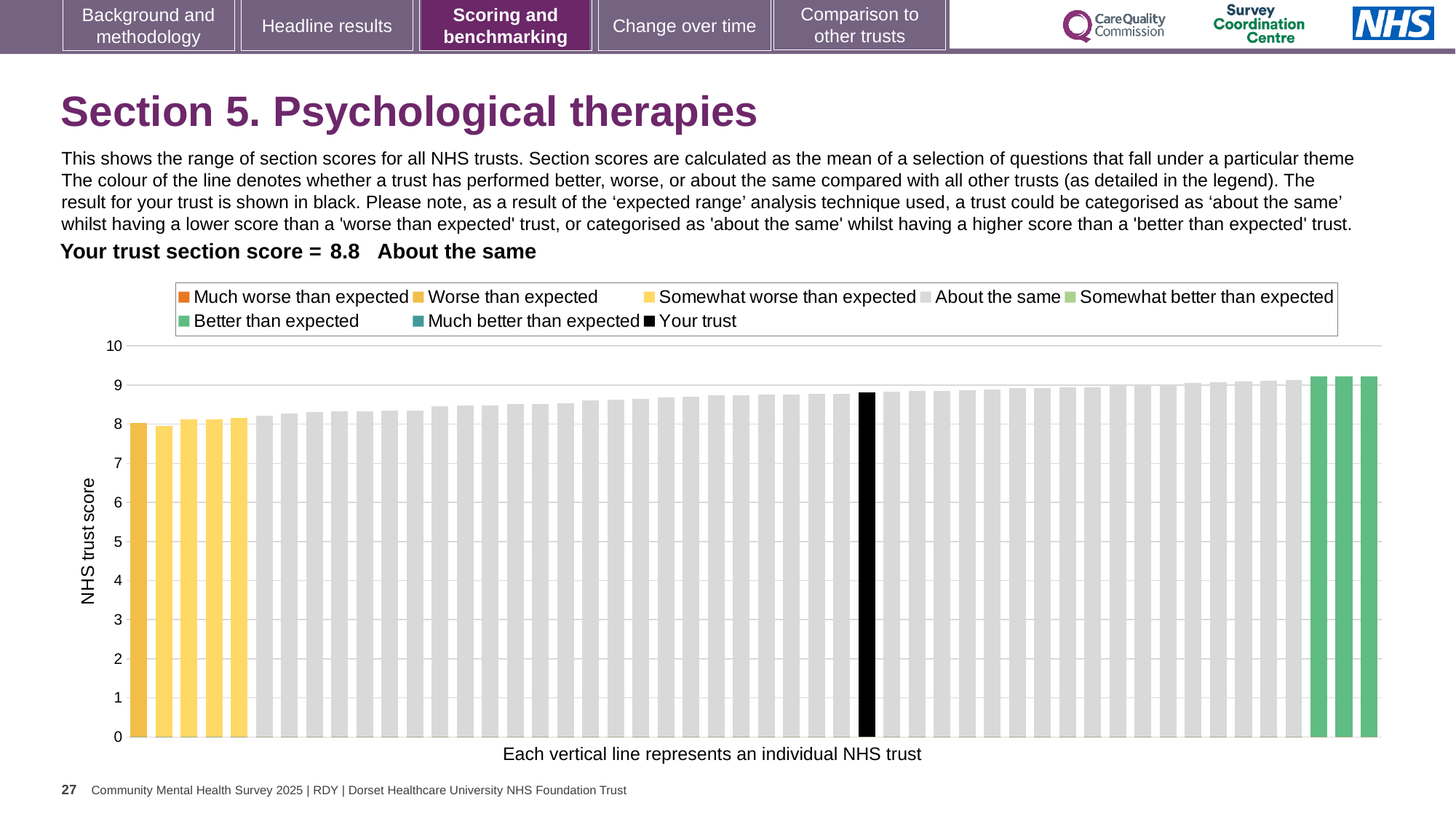
What colour is the bar representing your trust in the chart? black Do the bar values rise or fall from left to right along the x axis? rise Is the value of the highest bar in the chart greater or less than 9? greater How many light yellow 'Somewhat worse than expected' bars are shown in the chart? 4 Is the value of the black 'Your trust' bar greater or less than 8? greater How many green 'Better than expected' bars are shown in the chart? 3 What kind of chart is shown on the slide? bar chart What is the section score for your trust shown on the slide? 8.8 Is the value of the lowest bar in the chart greater or less than 9? less What is the label on the vertical axis of the chart? NHS trust score Which legend category do the highest-scoring bars in the chart belong to? Better than expected How many entries does the chart legend list? 8